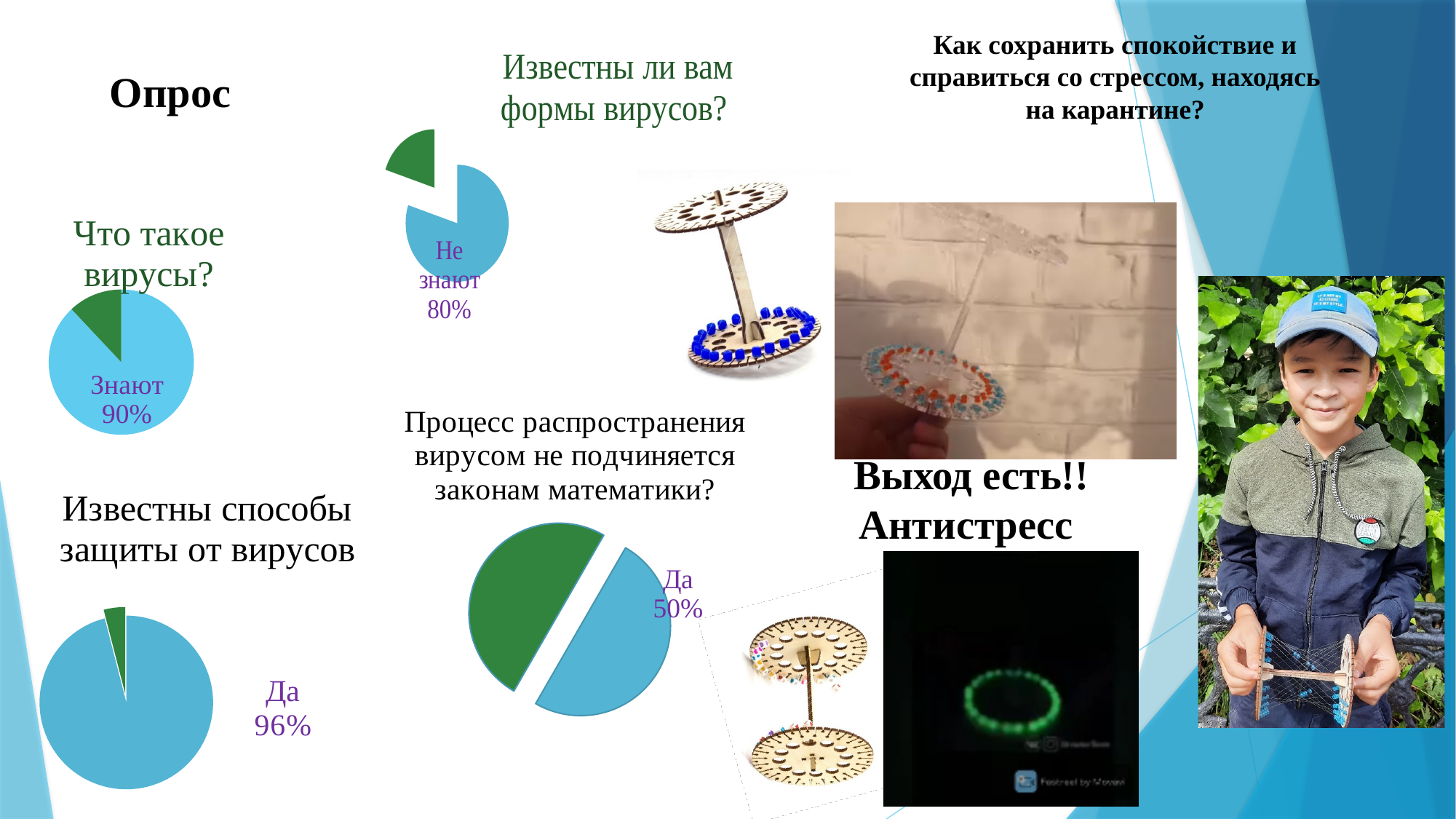
How many slices does the pie chart titled "Процесс распространения вирусом не подчиняется законам математики?" have? 2 In the pie chart titled "Известны способы защиты от вирусов", what percentage is labelled "Да"? 96% What colour is the slice labelled "Да 96%" in the pie chart titled "Известны способы защиты от вирусов"? blue In the pie chart titled "Что такое вирусы?", which slice is larger, the blue one or the green one? the blue one Which is larger: the "Да" share in the chart "Известны способы защиты от вирусов" or the "Да" share in the chart "Процесс распространения вирусом не подчиняется законам математики?"? Известны способы защиты от вирусов (96%) In the pie chart titled "Известны ли вам формы вирусов?", what percentage is labelled "Не знают"? 80% In the pie chart titled "Процесс распространения вирусом не подчиняется законам математики?", what percentage is labelled "Да"? 50% How many slices does the pie chart titled "Известны способы защиты от вирусов" have? 2 What is the difference between the "Знают" share (90%) in "Что такое вирусы?" and the "Не знают" share (80%) in "Известны ли вам формы вирусов?"? 10% In the pie chart titled "Известны ли вам формы вирусов?", is the "Не знают" share greater or less than 50%? greater What kind of chart is used under the title "Что такое вирусы?"? pie chart In the pie chart titled "Что такое вирусы?", what percentage is labelled "Знают"? 90%